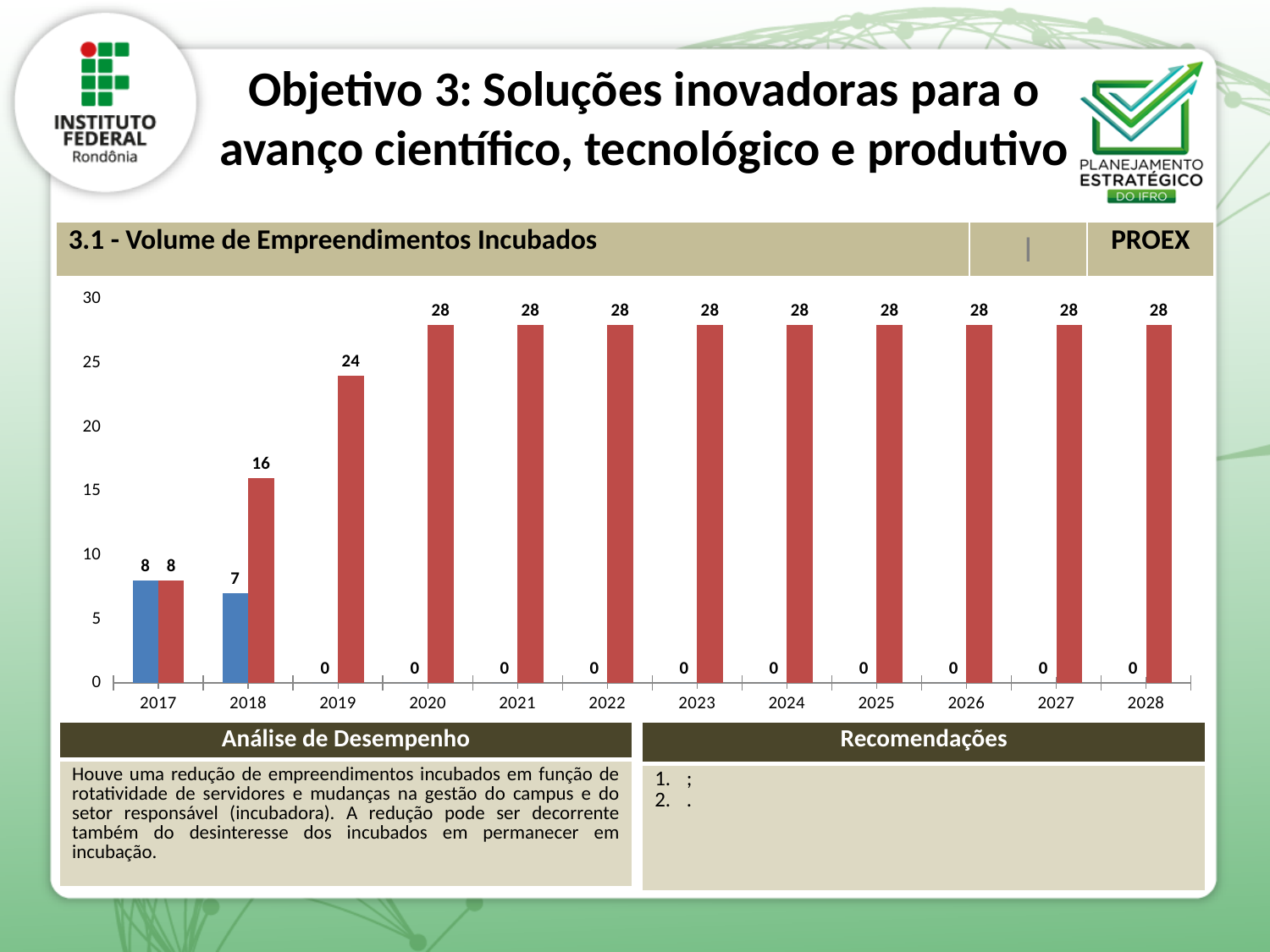
What is the difference between the red bar and the blue bar for 2018? 9 What is the value of the blue bar for 2017? 8 What is the value of the red bar for 2025? 28 What is the title of the chart? 3.1 - Volume de Empreendimentos Incubados How many years are shown on the x axis? 12 What is the value of the red bar for 2018? 16 Do the red bar values rise or fall from 2017 to 2020? rise Which year has the lowest red bar value? 2017 What type of chart is shown on the slide? bar chart Which is larger for 2019, the red bar or the blue bar? the red bar What is the value of the red bar for 2019? 24 What is the value of the blue bar for 2018? 7